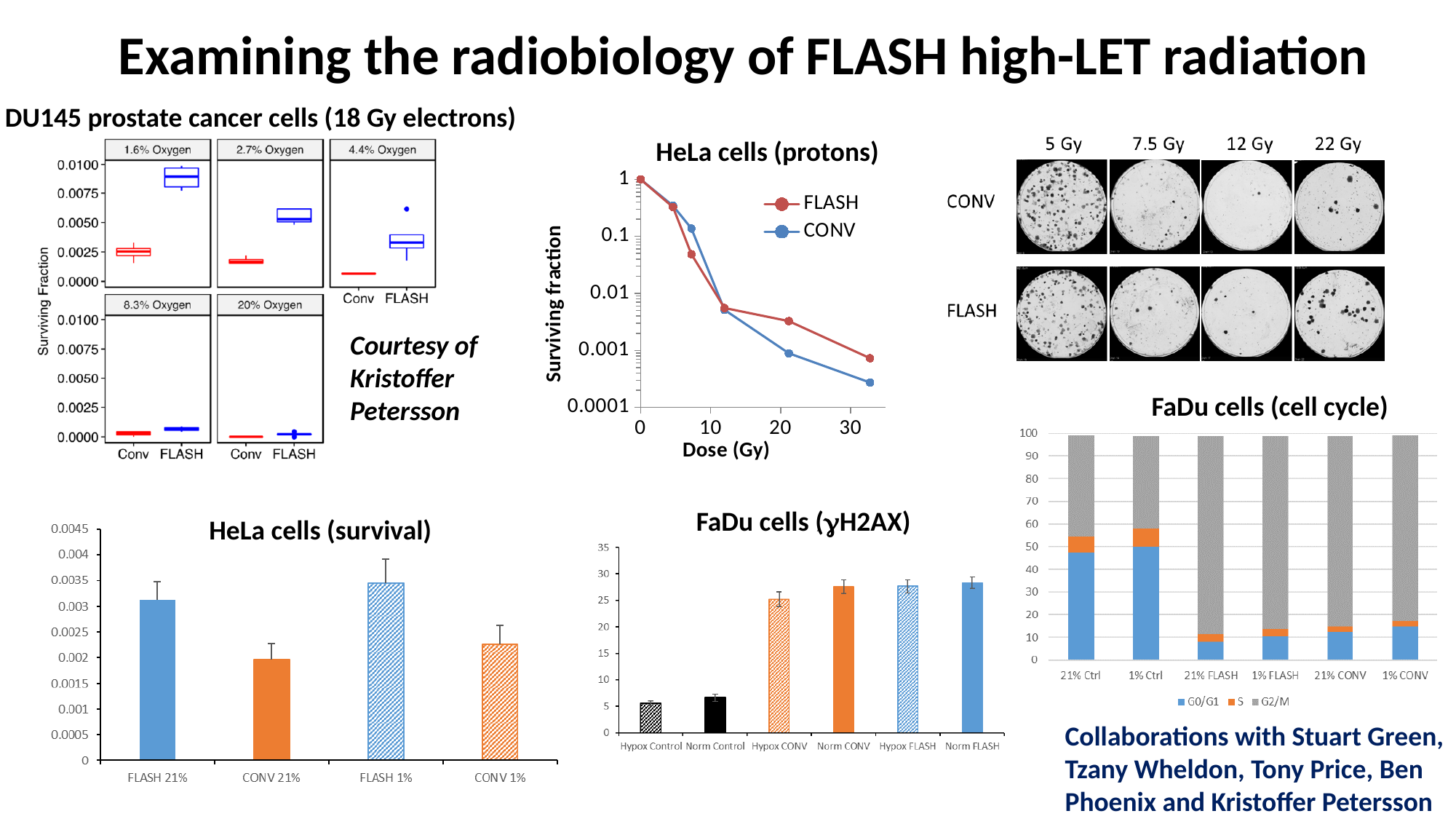
In the "HeLa cells (survival)" chart, which is larger, FLASH 21% or CONV 21%? FLASH 21% In the "FaDu cells (cell cycle)" chart, is the G0/G1 value for 21% Ctrl greater or less than 40? greater In the "HeLa cells (survival)" chart, is the value for CONV 21% greater or less than 0.0025? less How many categories are shown on the x axis of the "FaDu cells (γH2AX)" chart? 6 How many series does the legend of the "HeLa cells (protons)" chart list? 2 In the "HeLa cells (protons)" chart, does the surviving fraction rise or fall as dose increases? fall In the "HeLa cells (protons)" chart, what is the surviving fraction for FLASH at a dose of 0 Gy? 1 How many series does the legend of the "FaDu cells (cell cycle)" chart list? 3 In the "FaDu cells (γH2AX)" chart, which category has the lowest value? Hypox Control What kind of chart is the "HeLa cells (protons)" chart? line chart In the "FaDu cells (γH2AX)" chart, is the value for Hypox CONV greater or less than 20? greater How many bars are in the "HeLa cells (survival)" chart? 4